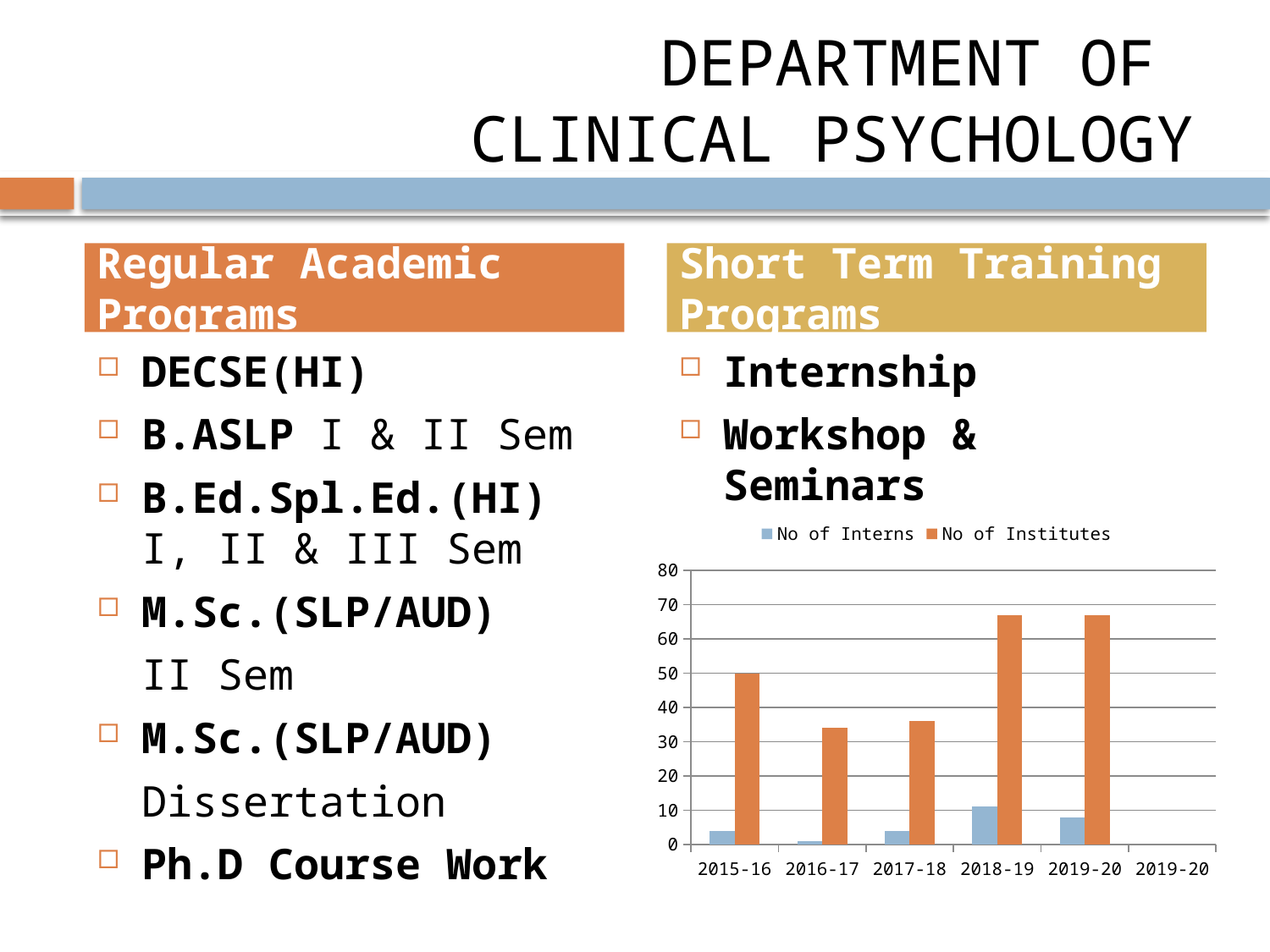
How many series does the chart legend list? 2 What kind of chart is shown on the slide? bar chart Which year has the lowest No of Interns? 2016-17 Which is larger, the No of Institutes in 2015-16 or in 2016-17? 2015-16 Which year has the highest No of Interns? 2018-19 Is the No of Institutes value for 2018-19 greater or less than 60? greater Is the No of Institutes value for 2016-17 greater or less than 40? less Is the No of Interns value for 2018-19 greater or less than 20? less Which colour represents No of Institutes in the chart? orange What are the two series named in the chart legend? No of Interns and No of Institutes